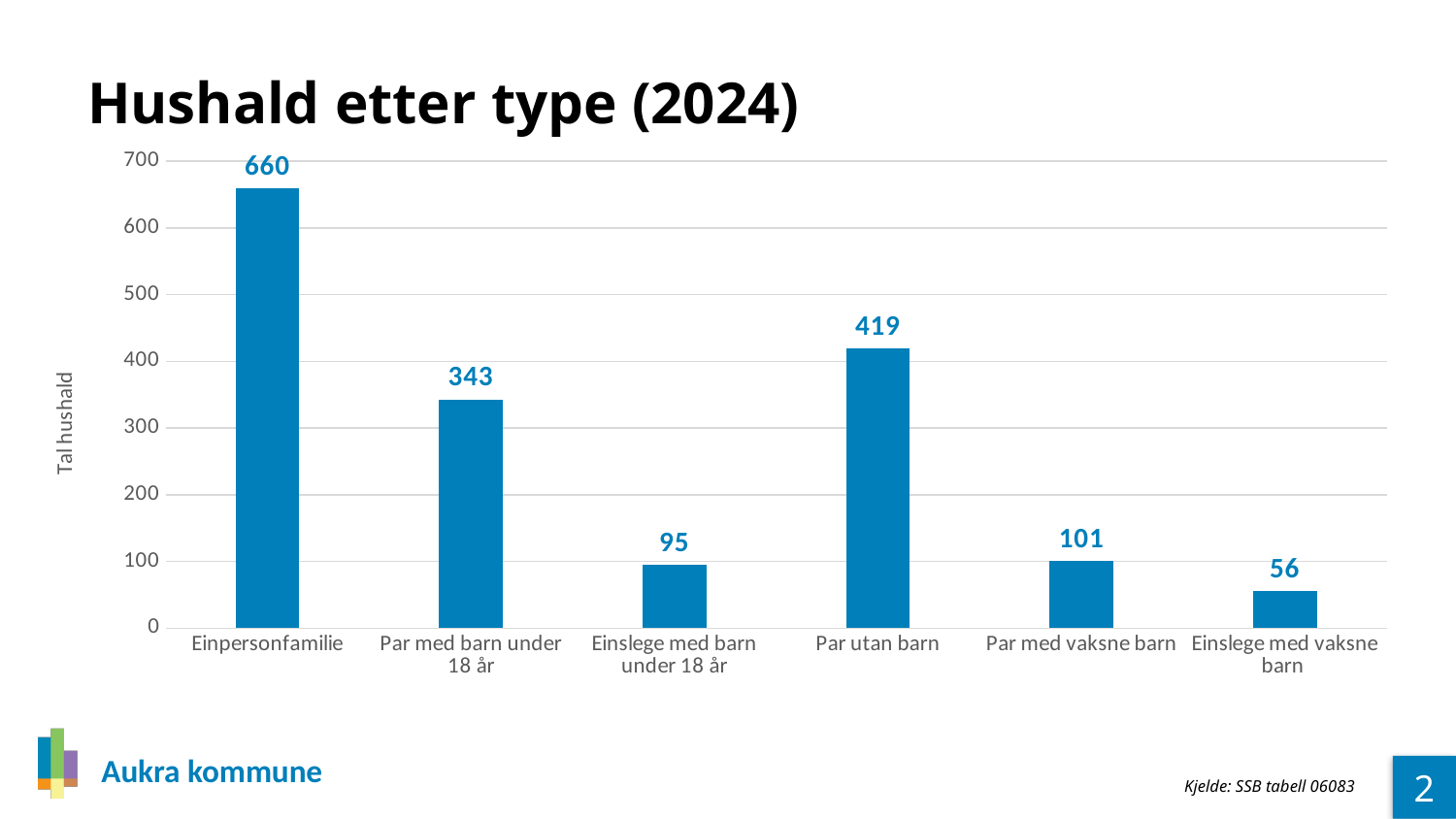
What is the difference between Einpersonfamilie and Par utan barn? 241 Which household type has the lowest value? Einslege med vaksne barn What is the title of the chart? Hushald etter type (2024) Which household type has the highest value? Einpersonfamilie What kind of chart is shown on the slide? Bar chart What is the value for Par med vaksne barn? 101 Which is larger, Par med barn under 18 år or Par utan barn? Par utan barn What is the value for Par utan barn? 419 What is the value for Einslege med vaksne barn? 56 What is the value for Einpersonfamilie? 660 What is the difference between Par med barn under 18 år and Einslege med barn under 18 år? 248 How many household types are shown on the chart? 6